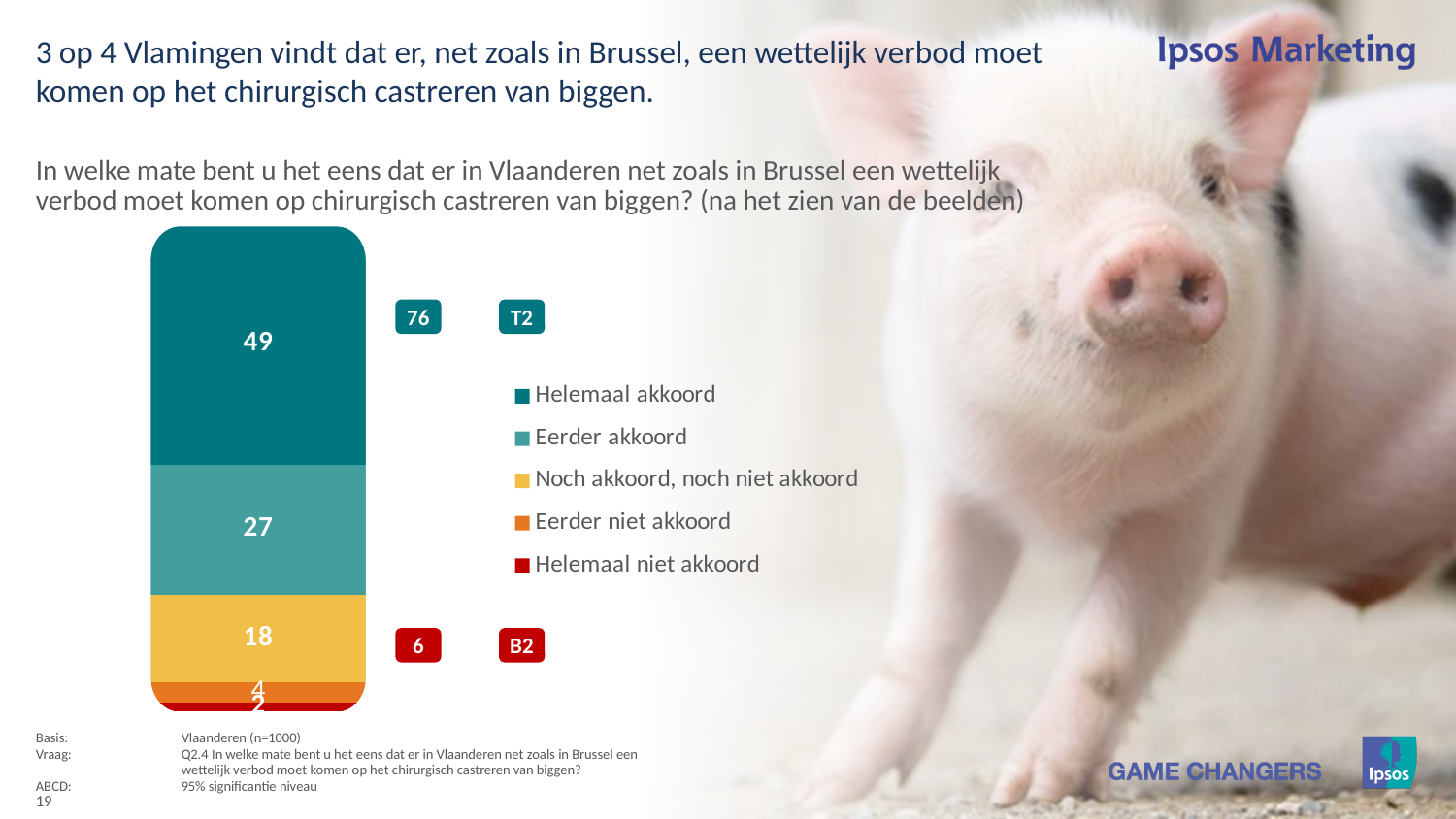
What is the value for 'Noch akkoord, noch niet akkoord' in the stacked bar? 18 What value is shown in the B2 box next to the bar? 6 Which is larger: the value for 'Eerder akkoord' or for 'Noch akkoord, noch niet akkoord'? Eerder akkoord What is the value for 'Eerder akkoord' in the stacked bar? 27 Which category has the largest segment in the stacked bar? Helemaal akkoord What value is shown in the T2 box next to the bar? 76 What kind of chart is shown on the slide? Stacked bar chart How many series does the legend list? 5 What is the value for 'Helemaal akkoord' in the stacked bar? 49 What colour is used for 'Helemaal akkoord' in the legend? Dark teal What is the combined value of the 'Helemaal akkoord' and 'Eerder akkoord' segments? 76 What is the difference between the values for 'Helemaal akkoord' and 'Eerder akkoord'? 22